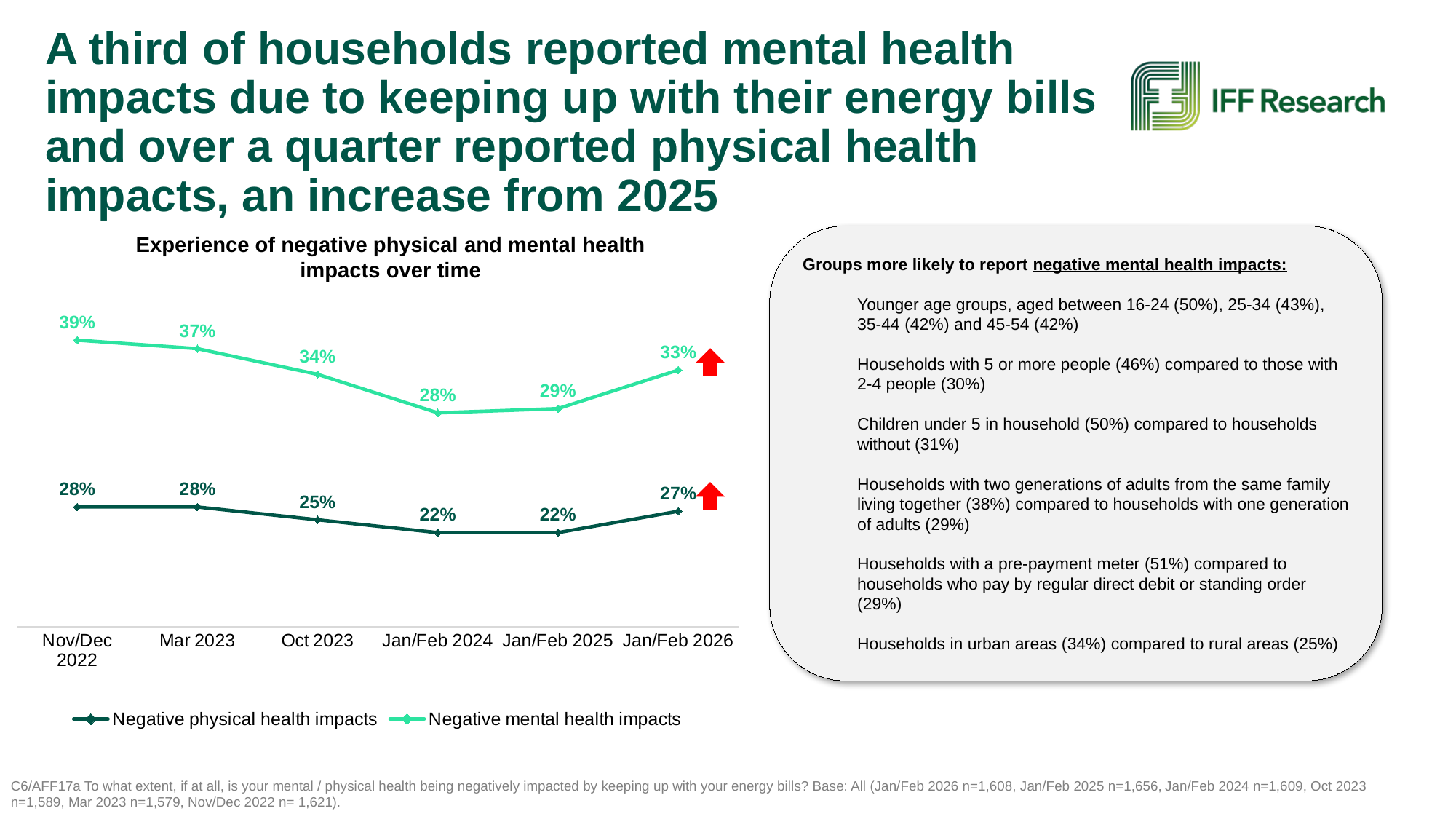
What percentage of households reported negative physical health impacts in Oct 2023? 25% How many time periods are shown on the x axis of the chart? 6 Which was higher in Mar 2023: negative physical health impacts or negative mental health impacts? Negative mental health impacts What percentage of households reported negative mental health impacts in Jan/Feb 2026? 33% By how many percentage points did negative physical health impacts rise from Jan/Feb 2025 to Jan/Feb 2026? 5 percentage points What type of chart is used to show the health impacts over time? Line chart What is the title of the chart? Experience of negative physical and mental health impacts over time In which period was the share reporting negative mental health impacts lowest? Jan/Feb 2024 In which period was the share reporting negative mental health impacts highest? Nov/Dec 2022 How did negative mental health impacts change from Nov/Dec 2022 to Jan/Feb 2024? They fell How many series does the chart legend list? 2 What is the difference between negative mental health impacts and negative physical health impacts in Jan/Feb 2026? 6 percentage points